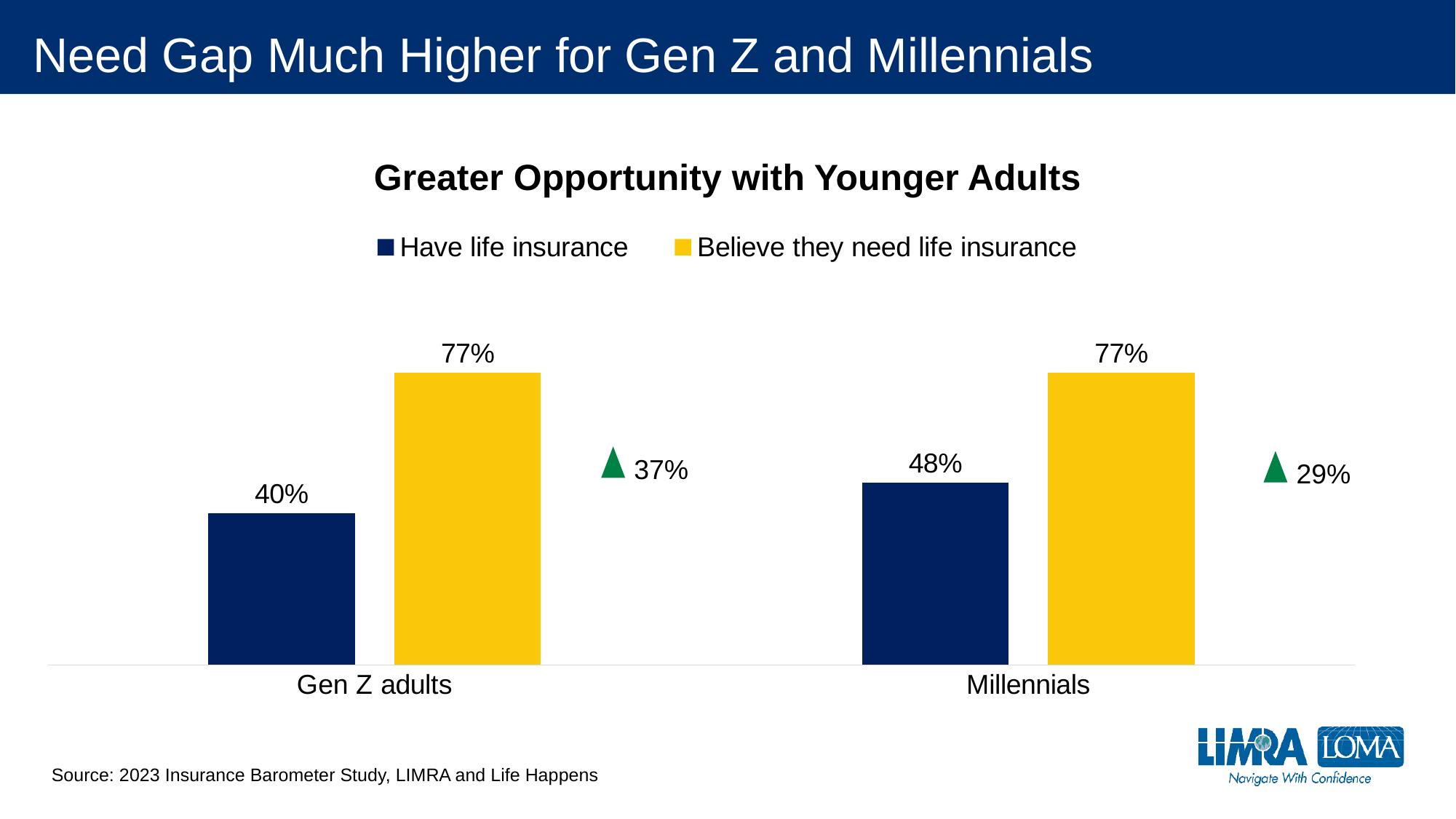
Which is larger: the share of Gen Z adults who have life insurance or the share of Millennials who have life insurance? Millennials What type of chart is shown on the slide? Bar chart How many generation categories are shown on the x axis? 2 What is the gap shown between believing they need life insurance and having it for Gen Z adults? 37% What is the difference between the share of Millennials who believe they need life insurance and the share who have it? 29% What percentage of Gen Z adults have life insurance? 40% Which series is shown in yellow in the legend? Believe they need life insurance Which group has the lower share of adults who have life insurance, Gen Z adults or Millennials? Gen Z adults What percentage of Millennials believe they need life insurance? 77% What is the title of the chart? Greater Opportunity with Younger Adults What percentage of Millennials have life insurance? 48% How many series does the legend list? 2